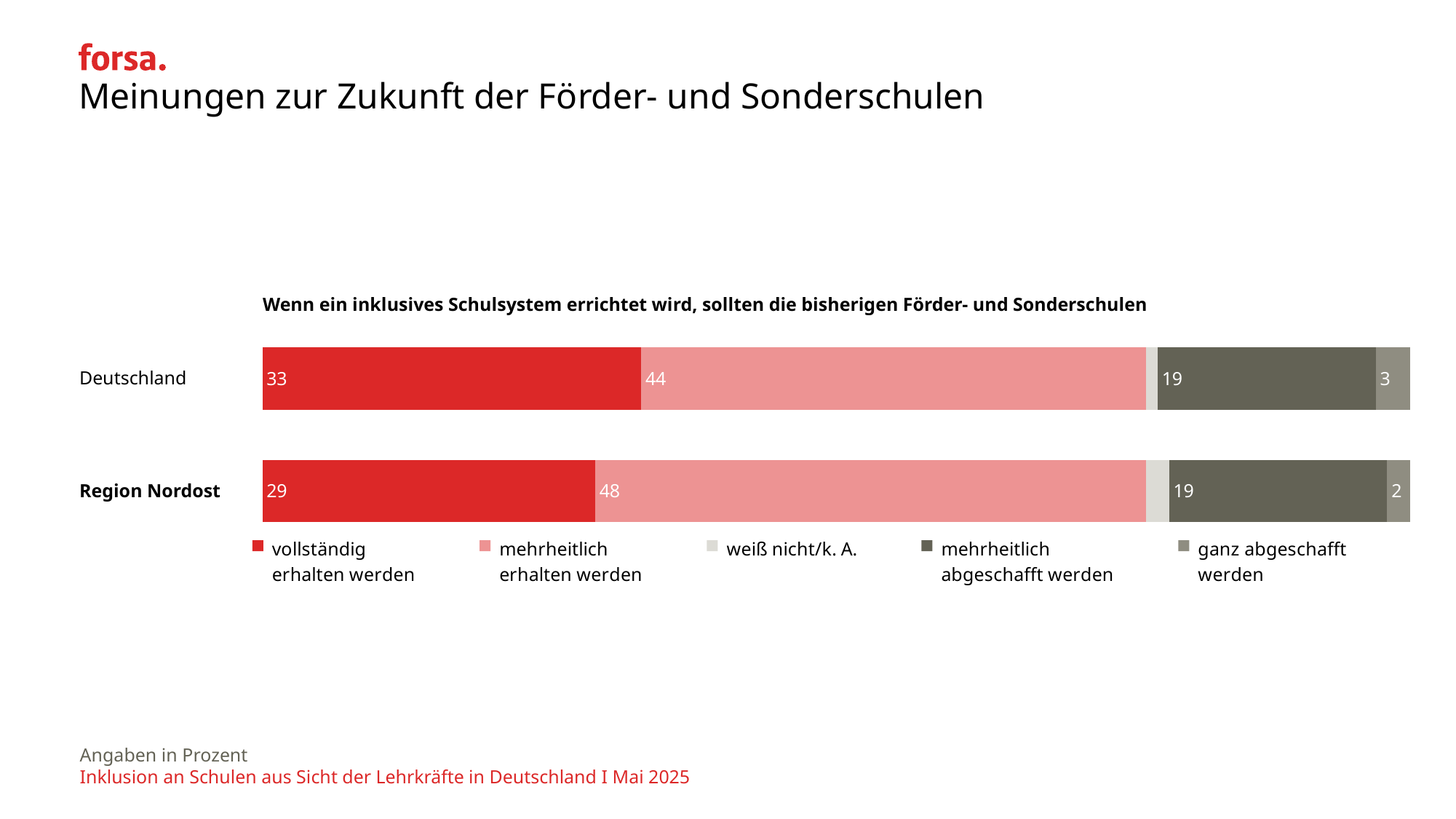
What is the difference between the 'vollständig erhalten werden' values for Deutschland and Region Nordost? 4 How many series does the legend list? 5 What is the value for 'mehrheitlich abgeschafft werden' for Deutschland? 19 What percentage of respondents in Deutschland say the Förder- und Sonderschulen should be 'vollständig erhalten werden'? 33 What kind of chart is shown on the slide? stacked bar chart Which category has the higher value for 'vollständig erhalten werden', Deutschland or Region Nordost? Deutschland Which category has the higher value for 'mehrheitlich erhalten werden', Deutschland or Region Nordost? Region Nordost What is the difference between the 'mehrheitlich erhalten werden' values for Region Nordost and Deutschland? 4 What is the value for 'ganz abgeschafft werden' in Region Nordost? 2 How many categories (rows) are shown in the chart? 2 Which response option has the largest share for Deutschland? mehrheitlich erhalten werden What is the value for 'mehrheitlich erhalten werden' in Region Nordost? 48